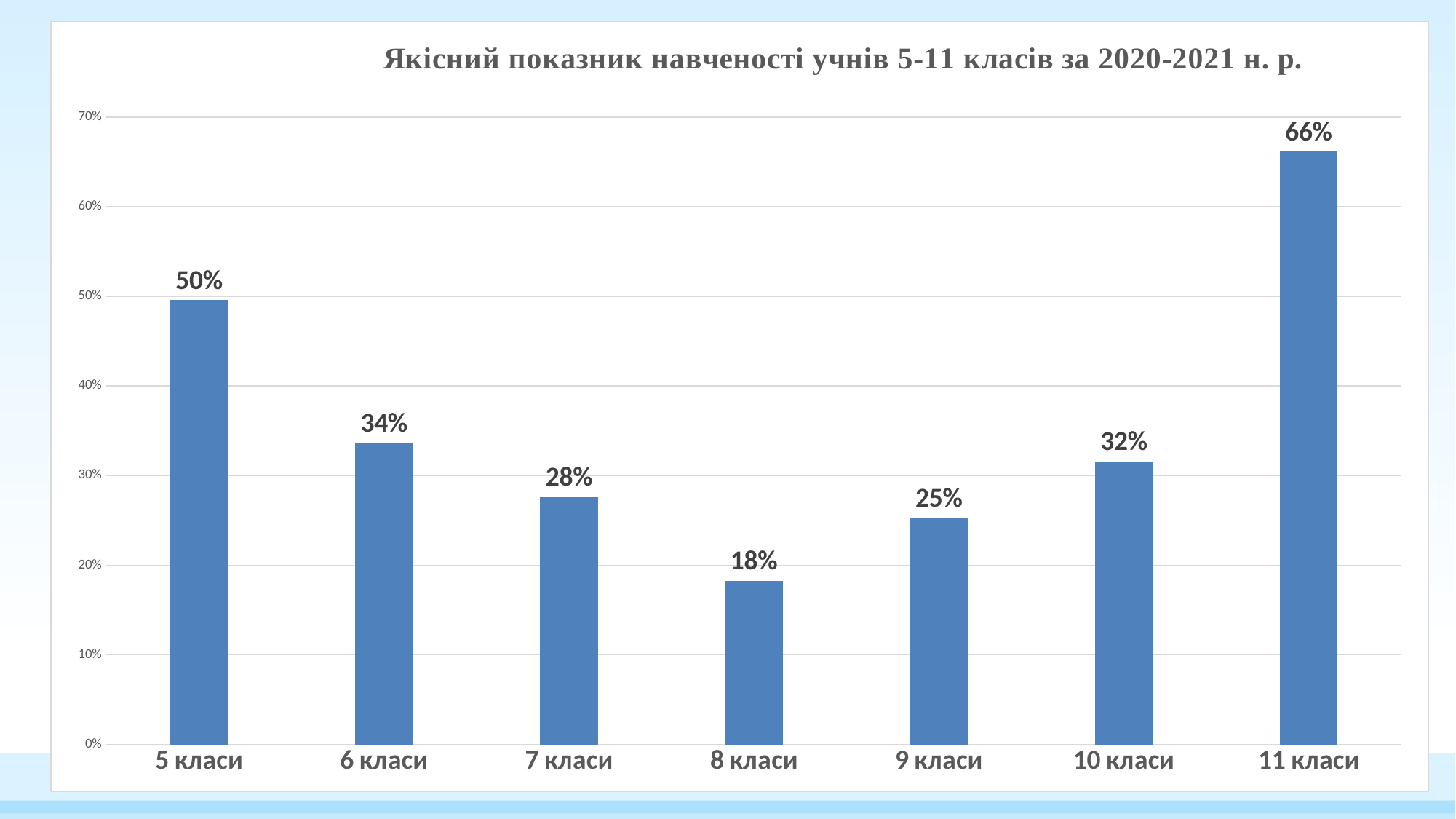
How many categories are shown on the chart? 7 Which category has the highest value? 11 класи Which is larger, the value for 7 класи or the value for 10 класи? 10 класи Is the value for 9 класи greater or less than 30%? less What kind of chart is shown on the slide? bar chart What is the value for 8 класи? 18% What is the difference between the values for 6 класи and 9 класи? 9% What is the title of the chart? Якісний показник навченості учнів 5-11 класів за 2020-2021 н. р. What is the difference between the values for 11 класи and 5 класи? 16% What is the value for 10 класи? 32% What is the value for 5 класи? 50% Which category has the lowest value? 8 класи